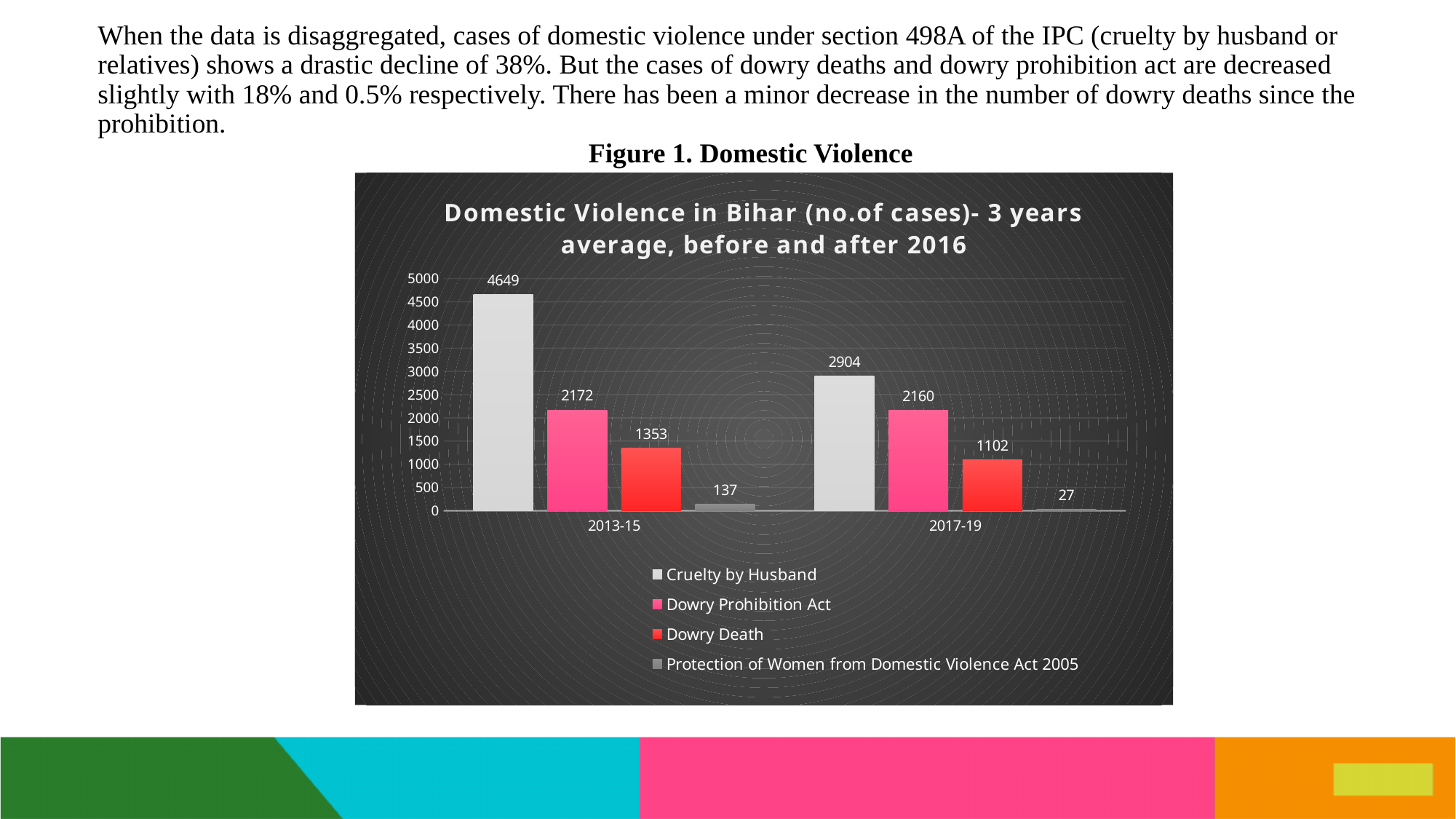
Which series has the highest value in 2017-19? Cruelty by Husband Which is larger: Dowry Death in 2013-15 or Dowry Death in 2017-19? Dowry Death in 2013-15 What kind of chart is shown? Bar chart What colour represents Dowry Death in the legend? Red What is the value for Dowry Death in 2017-19? 1102 Which series has the lowest value in 2013-15? Protection of Women from Domestic Violence Act 2005 How many categories are shown on the x axis? 2 What is the difference between the Cruelty by Husband values for 2013-15 and 2017-19? 1745 What is the value for Cruelty by Husband in 2013-15? 4649 What is the value for Dowry Prohibition Act in 2017-19? 2160 What is the value for Protection of Women from Domestic Violence Act 2005 in 2013-15? 137 How many series does the legend list? 4